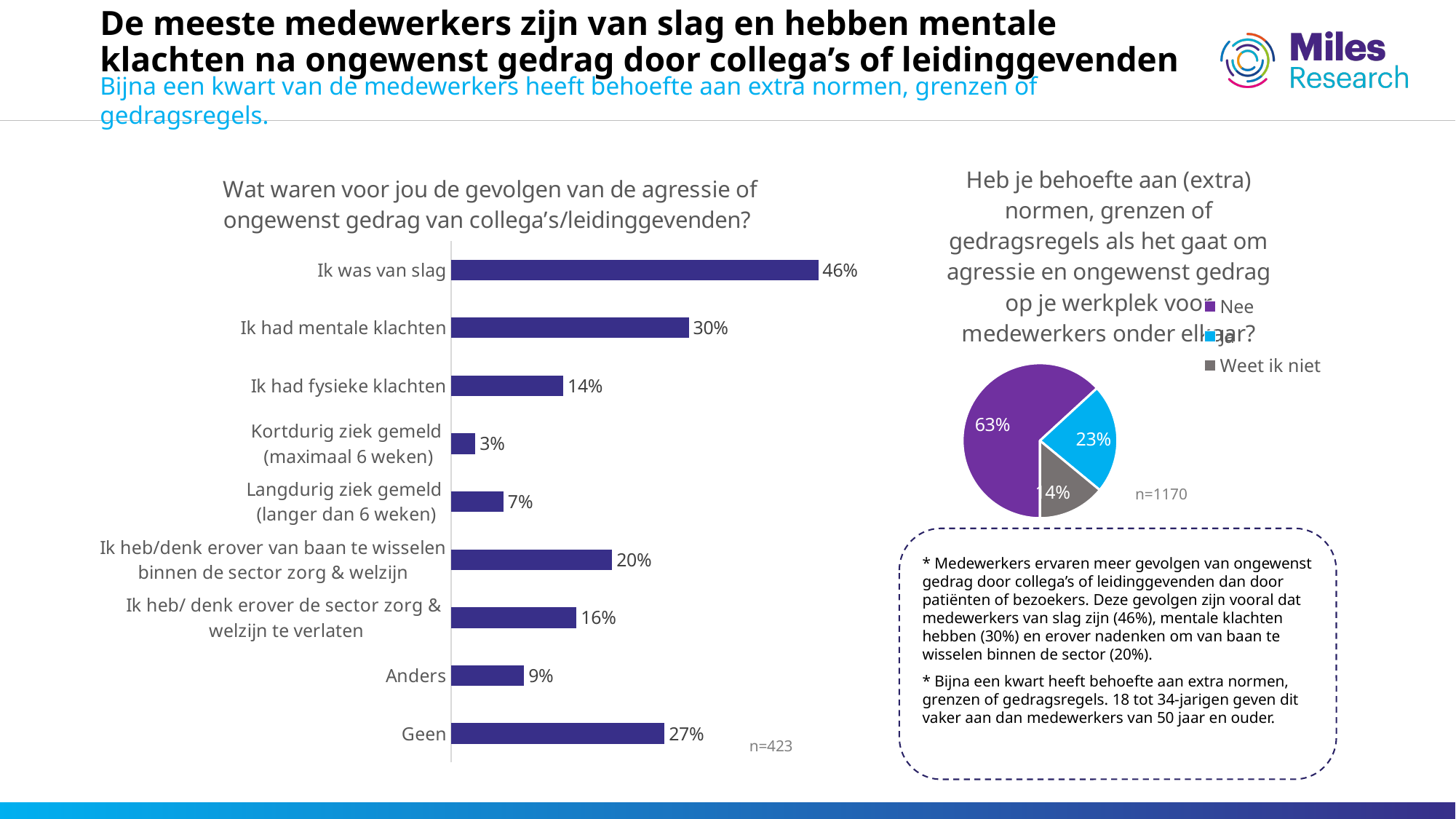
In the bar chart on the left, which is larger: "Geen" or "Ik heb/denk erover van baan te wisselen binnen de sector zorg & welzijn"? Geen In the pie chart on the right, what share is "Nee"? 63% How many entries does the legend of the pie chart on the right list? 3 In the bar chart on the left, which category has the highest value? Ik was van slag In the bar chart on the left, what is the difference between "Ik was van slag" and "Ik had mentale klachten"? 16% In the bar chart on the left, what is the value for "Ik was van slag"? 46% In the pie chart on the right, which slice is the smallest? Weet ik niet What kind of chart is the chart on the left? Bar chart How many categories does the bar chart on the left show? 9 In the pie chart on the right, what share is "Ja"? 23% In the bar chart on the left, which category has the lowest value? Kortdurig ziek gemeld (maximaal 6 weken) In the bar chart on the left, what is the value for "Ik had fysieke klachten"? 14%